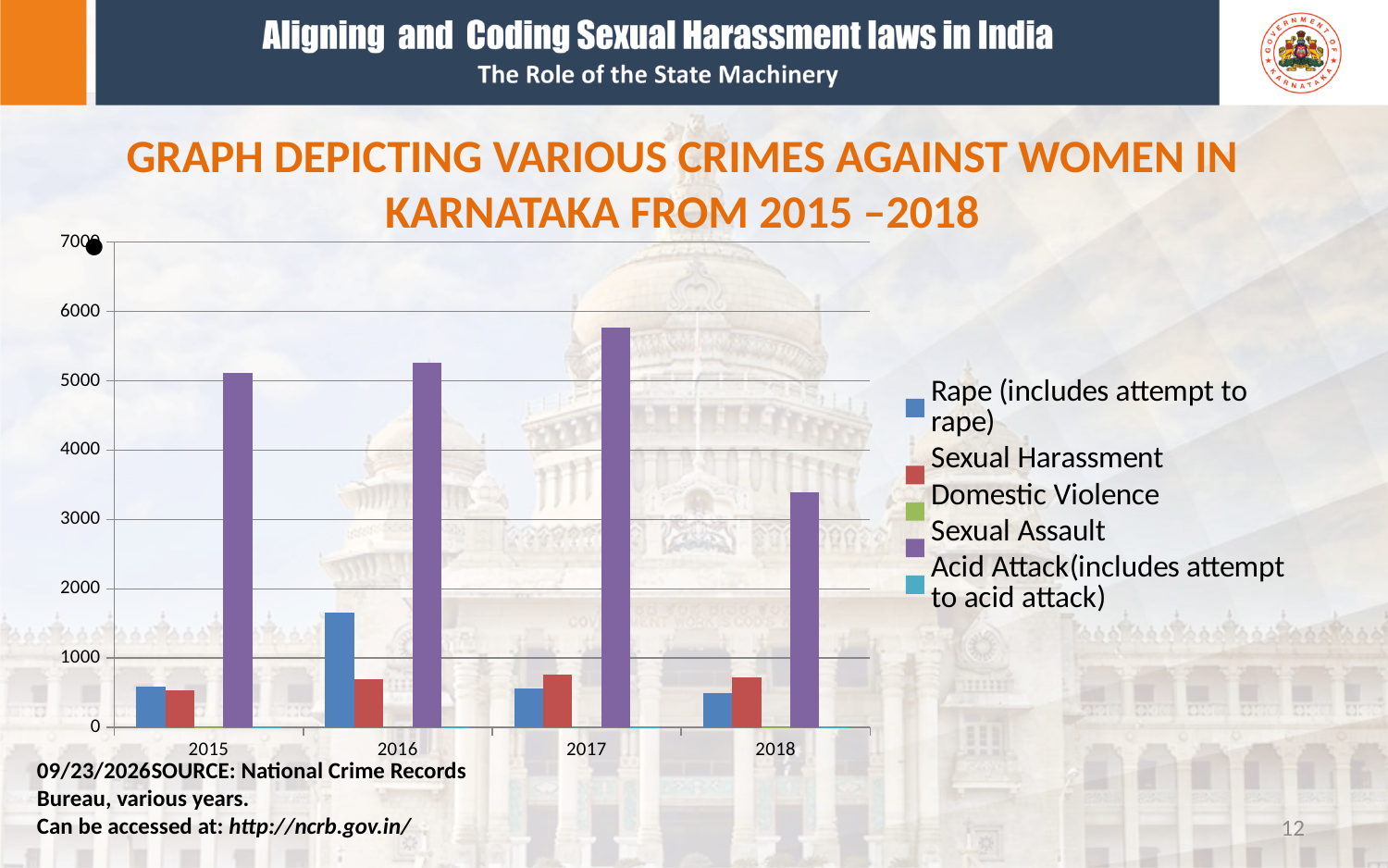
Which is larger: Sexual Assault in 2017 or Sexual Assault in 2018? 2017 Is the value for Sexual Assault in 2018 greater or less than 4000? less How many series does the legend list? 5 In which year is the Rape (includes attempt to rape) bar the highest? 2016 In which year is the Sexual Assault bar the lowest? 2018 What kind of chart is shown on the slide? bar chart How many years are shown on the x axis? 4 Which series is shown in purple in the legend? Sexual Assault Is the value for Sexual Assault in 2017 greater or less than 5000? greater Does the Sexual Assault value rise or fall from 2017 to 2018? fall In which year is the Sexual Assault bar the highest? 2017 Is the value for Rape (includes attempt to rape) in 2016 greater or less than 1000? greater